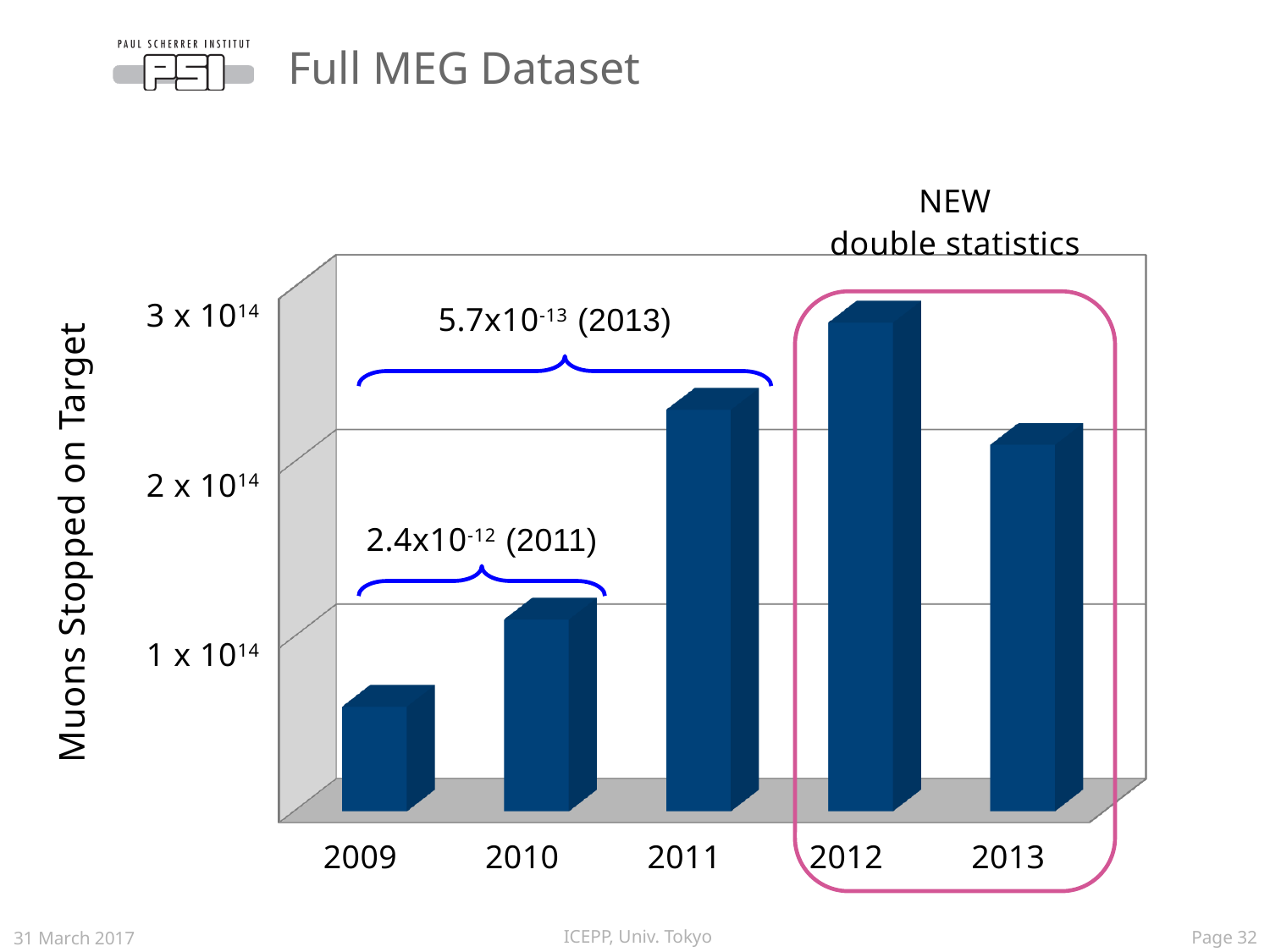
What is the label of the vertical axis? Muons Stopped on Target Which year has the larger value, 2012 or 2013? 2012 Which years are enclosed by the pink box labelled 'NEW double statistics'? 2012 and 2013 Which year has the highest number of muons stopped on target? 2012 Is the value for 2013 greater or less than 3 x 10^14? less Is the value for 2012 greater or less than 2 x 10^14? greater Is the value for 2011 greater or less than 2 x 10^14? greater Which year has the larger value, 2010 or 2011? 2011 How many years (categories) are plotted on the x axis? 5 Which year has the lowest number of muons stopped on target? 2009 What kind of chart is shown on the slide? bar chart